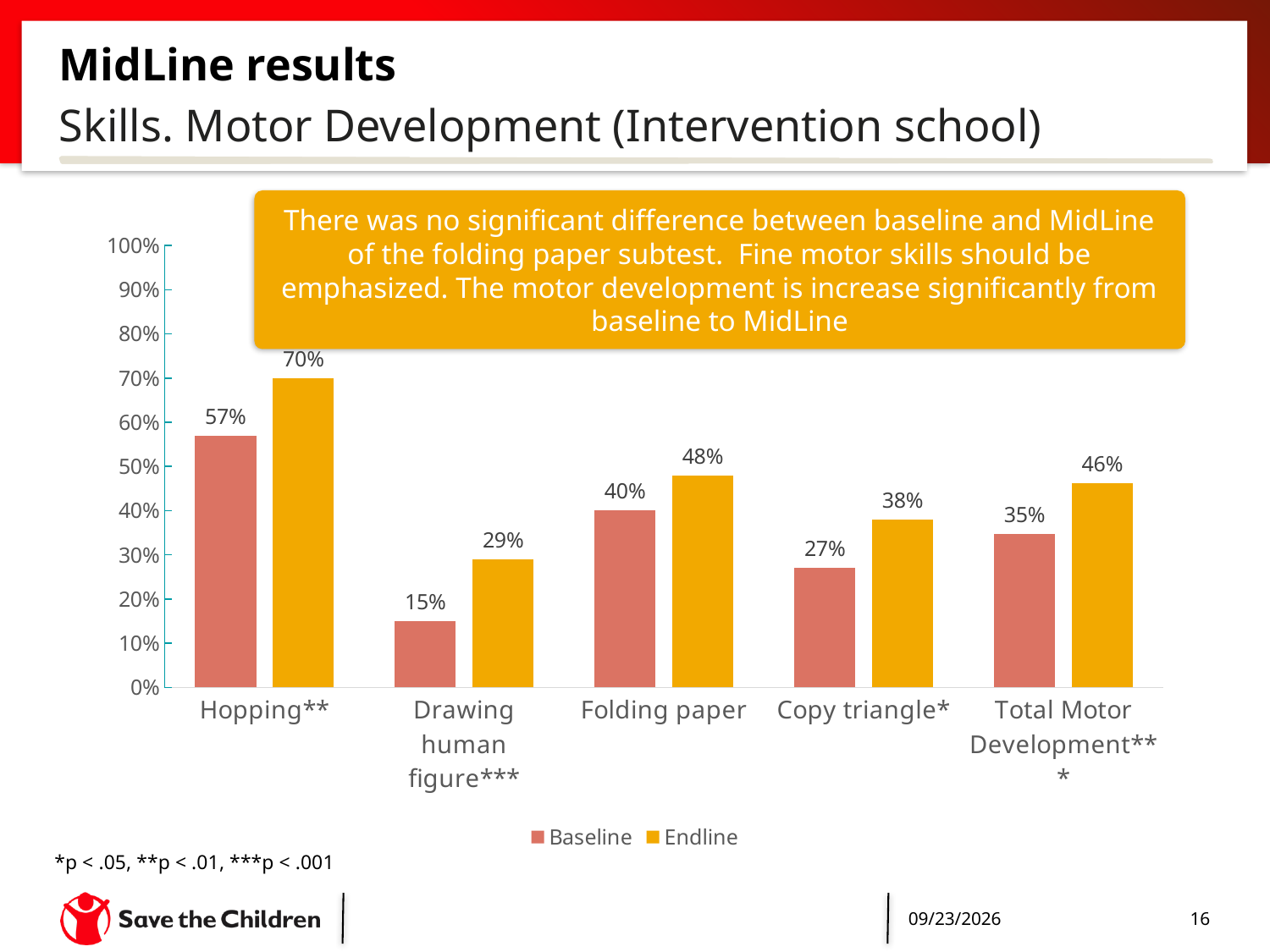
Which is larger for Total Motor Development***: the Baseline value or the Endline value? Endline What is the Baseline value for Hopping**? 57% What is the difference between the Endline and Baseline values for Folding paper? 8% How many categories are shown on the x axis? 5 Is the Baseline value for Copy triangle* greater or less than 30%? less Which category has the lowest Baseline value? Drawing human figure*** Which category has the highest Endline value? Hopping** Which colour represents the Endline series? yellow/orange What is the Endline value for Copy triangle*? 38% How many series does the legend list? 2 What is the Endline value for Drawing human figure***? 29% What kind of chart is shown on the slide? bar chart